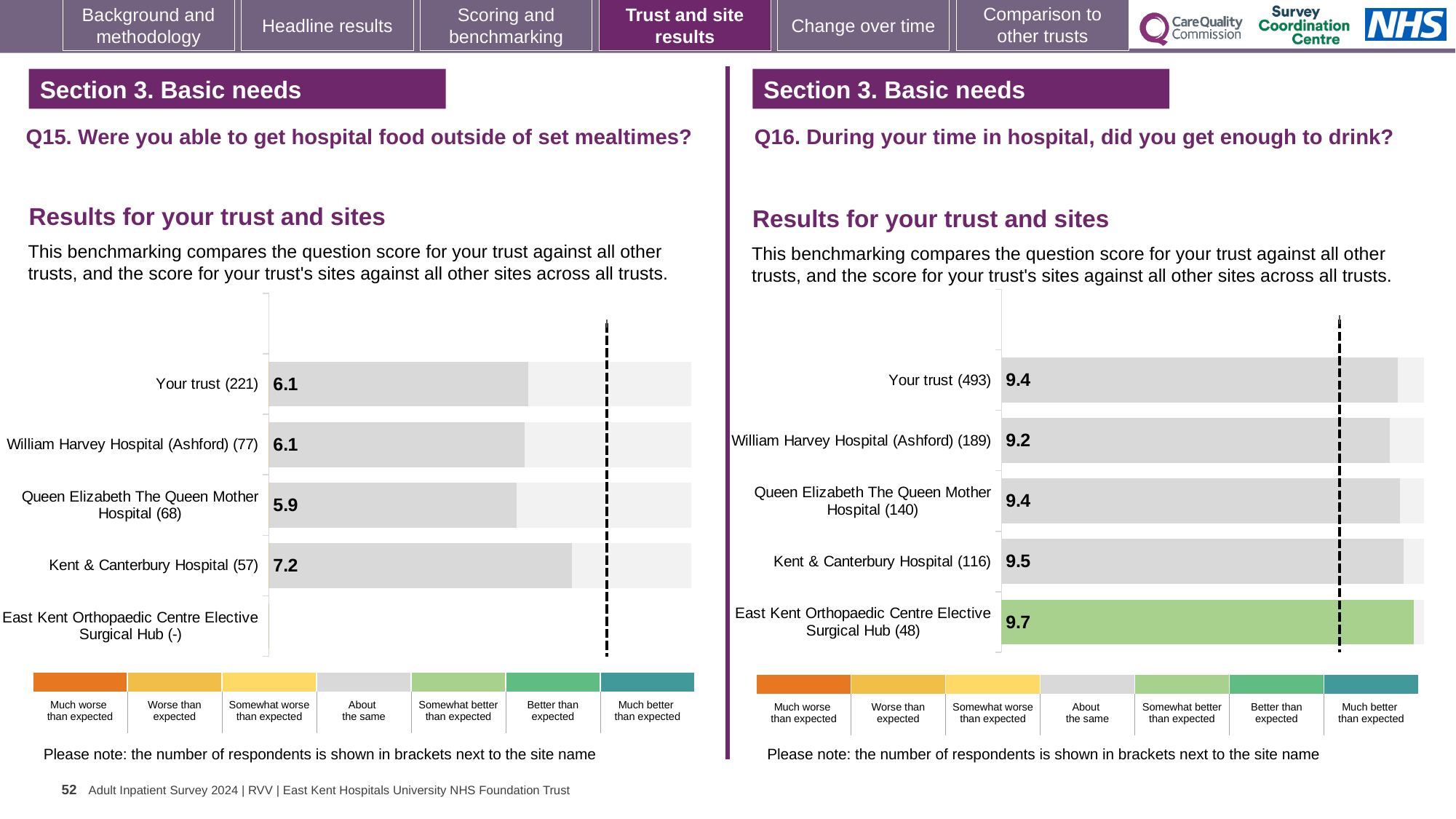
On the Q15 chart (left), what is the difference between the scores for Kent & Canterbury Hospital and Queen Elizabeth The Queen Mother Hospital? 1.3 On the Q15 chart (left), which site has the lowest score? Queen Elizabeth The Queen Mother Hospital What type of chart is used on the Q16 chart (right)? Bar chart On the Q16 chart (right), what is the score for William Harvey Hospital (Ashford)? 9.2 On the Q16 chart (right), what is the difference between the scores for East Kent Orthopaedic Centre Elective Surgical Hub and William Harvey Hospital (Ashford)? 0.5 On the Q16 chart (right), which has the higher score: Kent & Canterbury Hospital or Your trust? Kent & Canterbury Hospital On the Q15 chart (left), what is the score for Kent & Canterbury Hospital? 7.2 On the Q16 chart (right), which site has the highest score? East Kent Orthopaedic Centre Elective Surgical Hub On the Q16 chart (right), which site has the lowest score? William Harvey Hospital (Ashford) On the Q15 chart (left), which site has the highest score? Kent & Canterbury Hospital On the Q16 chart (right), how many respondents are shown in brackets for Your trust? 493